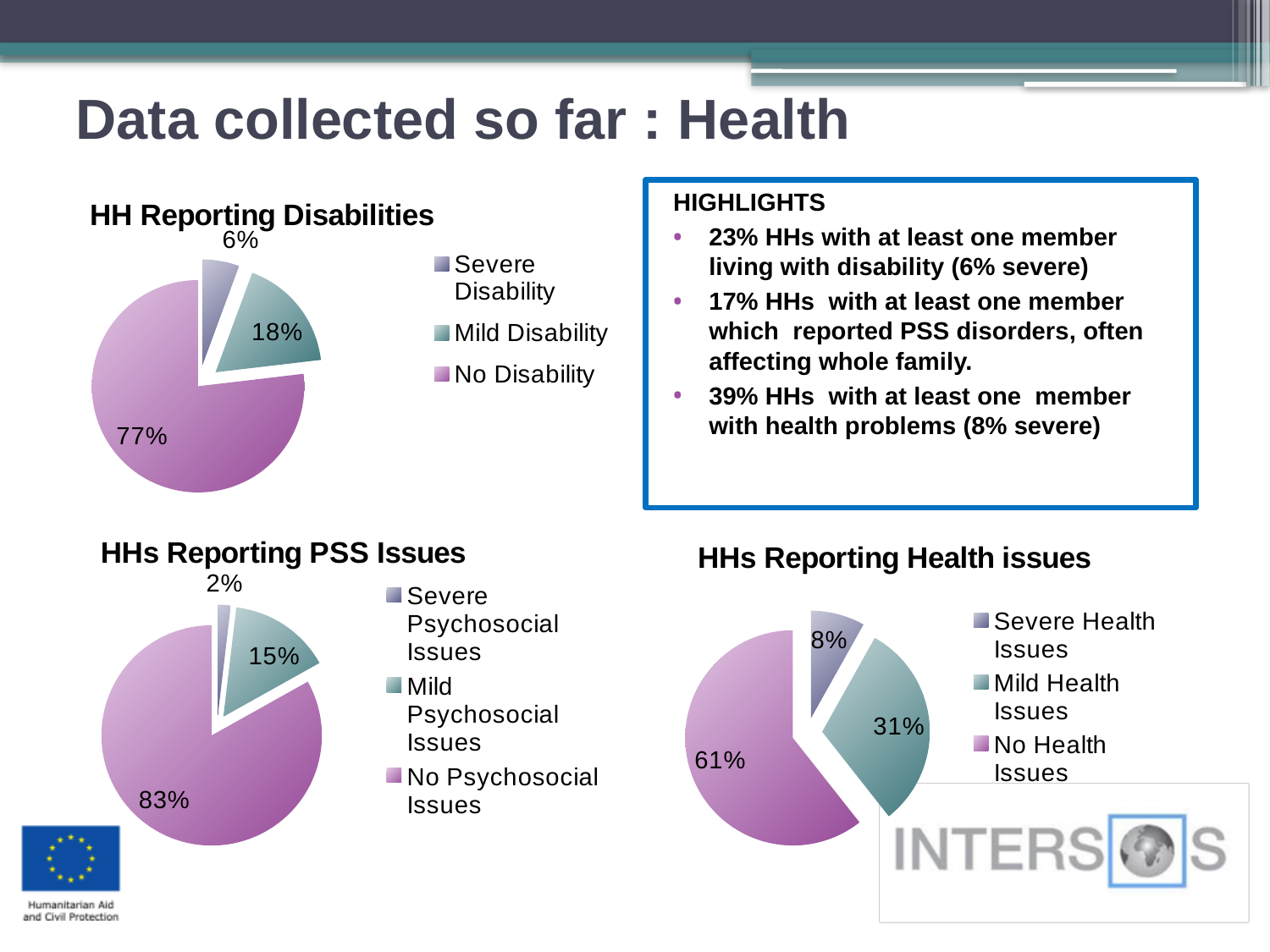
In the 'HHs Reporting Health issues' chart, what percentage is shown for No Health Issues? 61% In the 'HHs Reporting Health issues' chart, which is larger: Mild Health Issues or Severe Health Issues? Mild Health Issues In the 'HH Reporting Disabilities' chart, which category has the smallest share? Severe Disability In the 'HH Reporting Disabilities' chart, what percentage is shown for No Disability? 77% In the 'HH Reporting Disabilities' chart, what percentage is shown for Mild Disability? 18% What type of chart is 'HH Reporting Disabilities'? Pie chart In the 'HHs Reporting Health issues' chart, what is the difference between the Mild Health Issues and Severe Health Issues percentages? 23% In the 'HHs Reporting PSS Issues' chart, what percentage is shown for Mild Psychosocial Issues? 15% How many categories does the legend of the 'HHs Reporting PSS Issues' chart list? 3 In the 'HHs Reporting PSS Issues' chart, which category has the largest share? No Psychosocial Issues In the 'HHs Reporting Health issues' chart, what percentage is shown for Severe Health Issues? 8% In the 'HHs Reporting PSS Issues' chart, what percentage is shown for Severe Psychosocial Issues? 2%